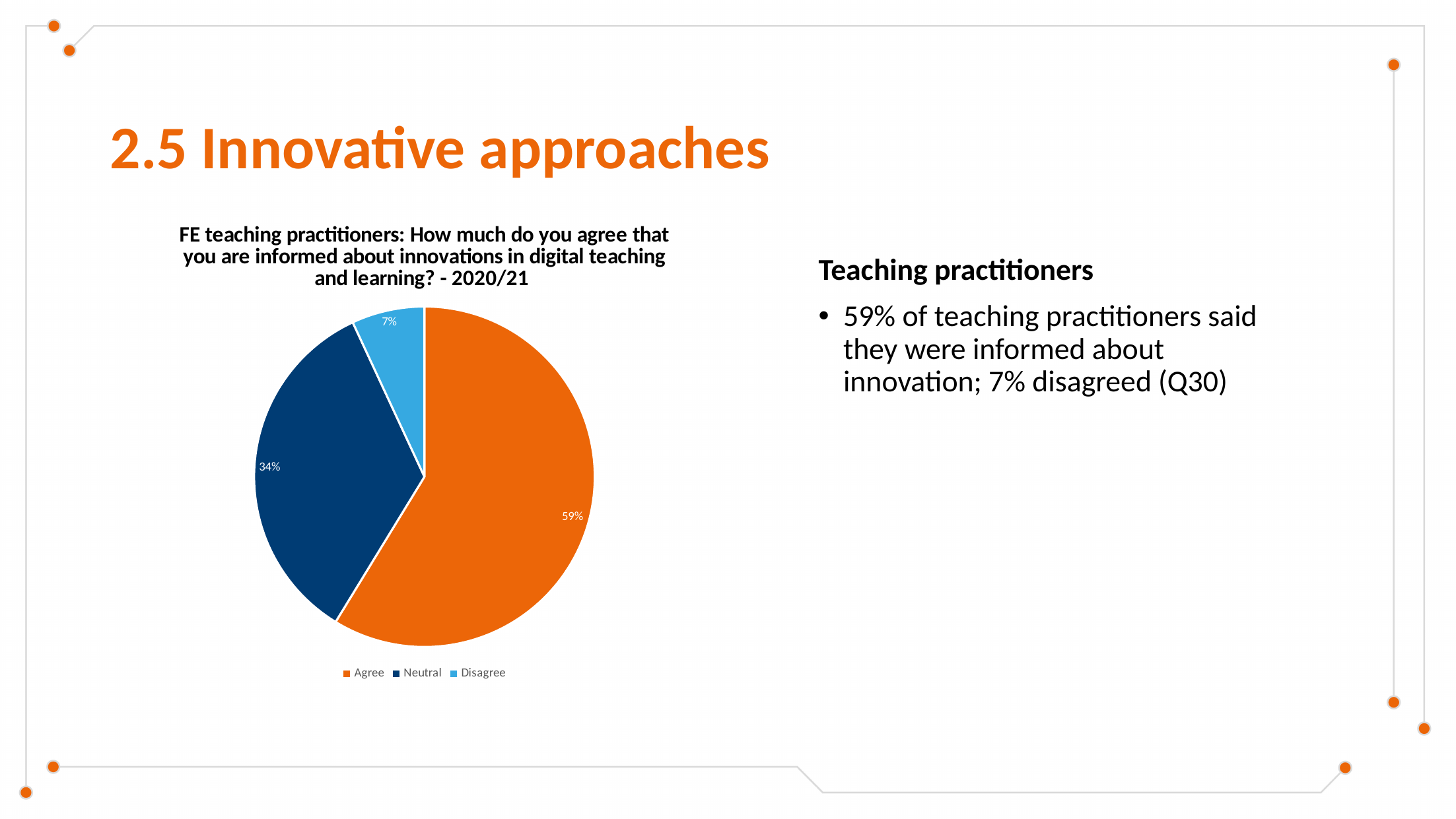
Which response category has the largest share of the pie? Agree Which response category has the smallest share of the pie? Disagree What colour is the Agree slice in the pie chart? Orange What is the difference in percentage points between the Neutral and Disagree slices? 27 Which year does the chart title say the data is for? 2020/21 What is the difference in percentage points between the Agree and Neutral slices? 25 What percentage of FE teaching practitioners answered Neutral? 34% Which is larger, the Neutral slice or the Disagree slice? Neutral How many response categories are shown in the pie chart? 3 What percentage of FE teaching practitioners answered Agree? 59% What percentage of FE teaching practitioners answered Disagree? 7% What type of chart is shown on the slide? Pie chart